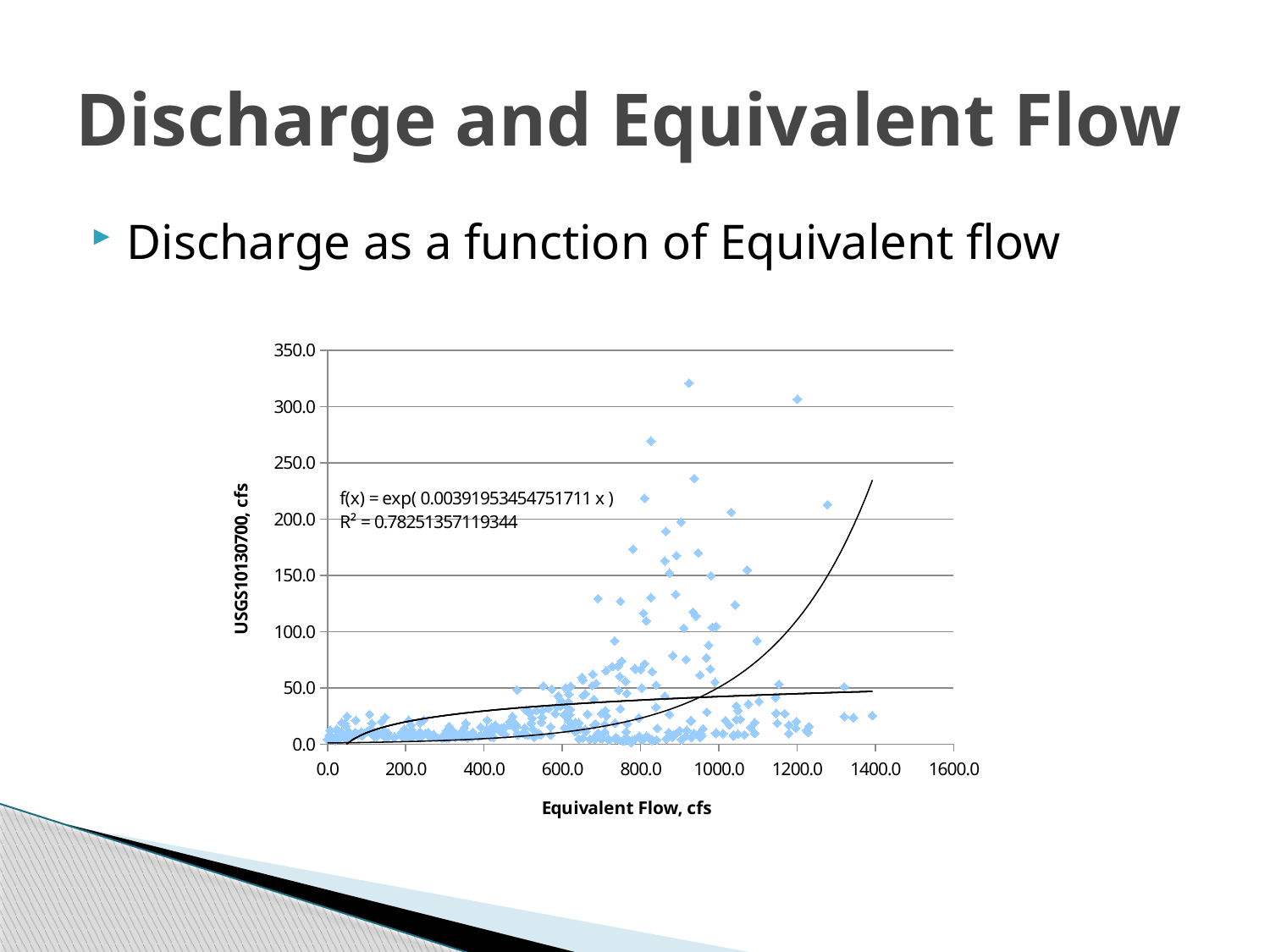
What is the title of the y axis of the chart? USGS10130700, cfs What R² value is printed on the chart? 0.78251357119344 What is the highest tick value shown on the x axis? 1600.0 What is the highest tick value shown on the y axis? 350.0 Roughly at which x-axis tick does the highest data point lie: closer to 800.0 or to 1400.0? 800.0 What kind of chart is shown on the slide? scatter chart What is the title of the x axis of the chart? Equivalent Flow, cfs What fitted equation f(x) is printed on the chart? f(x) = exp( 0.00391953454751711 x ) Are most of the plotted data points above or below 100.0 on the y axis? below Is the value of the highest data point greater or less than 250.0? greater Is the highest plotted data point greater or less than 300.0 on the y axis? greater Does the exponential fitted curve rise or fall as Equivalent Flow increases? rise